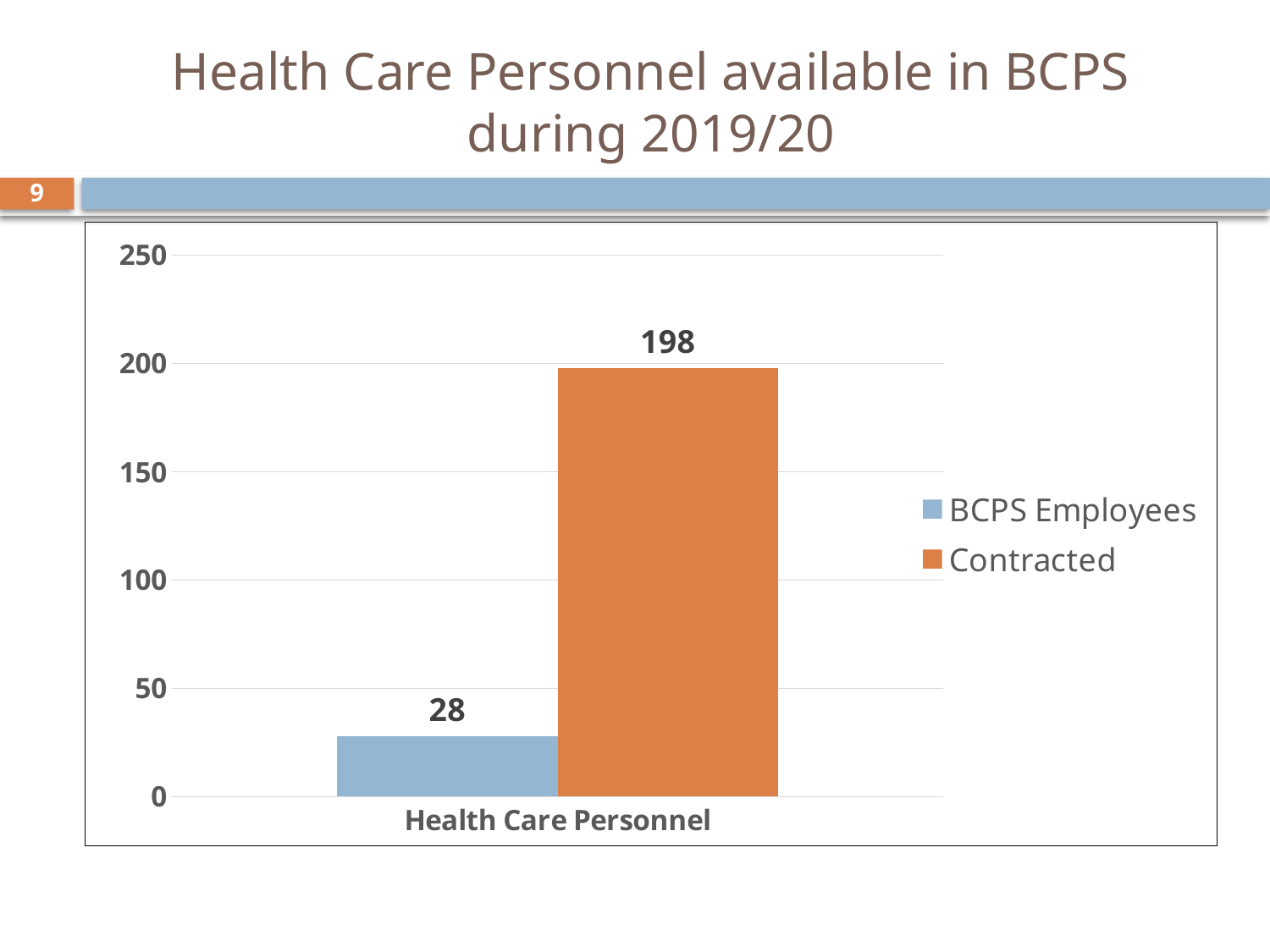
What is the value for Contracted? 198 What is the value for BCPS Employees? 28 What is the category label on the x axis? Health Care Personnel Which is larger, BCPS Employees or Contracted? Contracted Is the value for Contracted greater or less than 150? greater What colour is the bar for Contracted? orange Which series has the lowest value? BCPS Employees What is the difference between the Contracted and BCPS Employees values? 170 What kind of chart is shown on the slide? bar chart How many series does the legend list? 2 Is the value for BCPS Employees greater or less than 50? less Which series has the highest value? Contracted